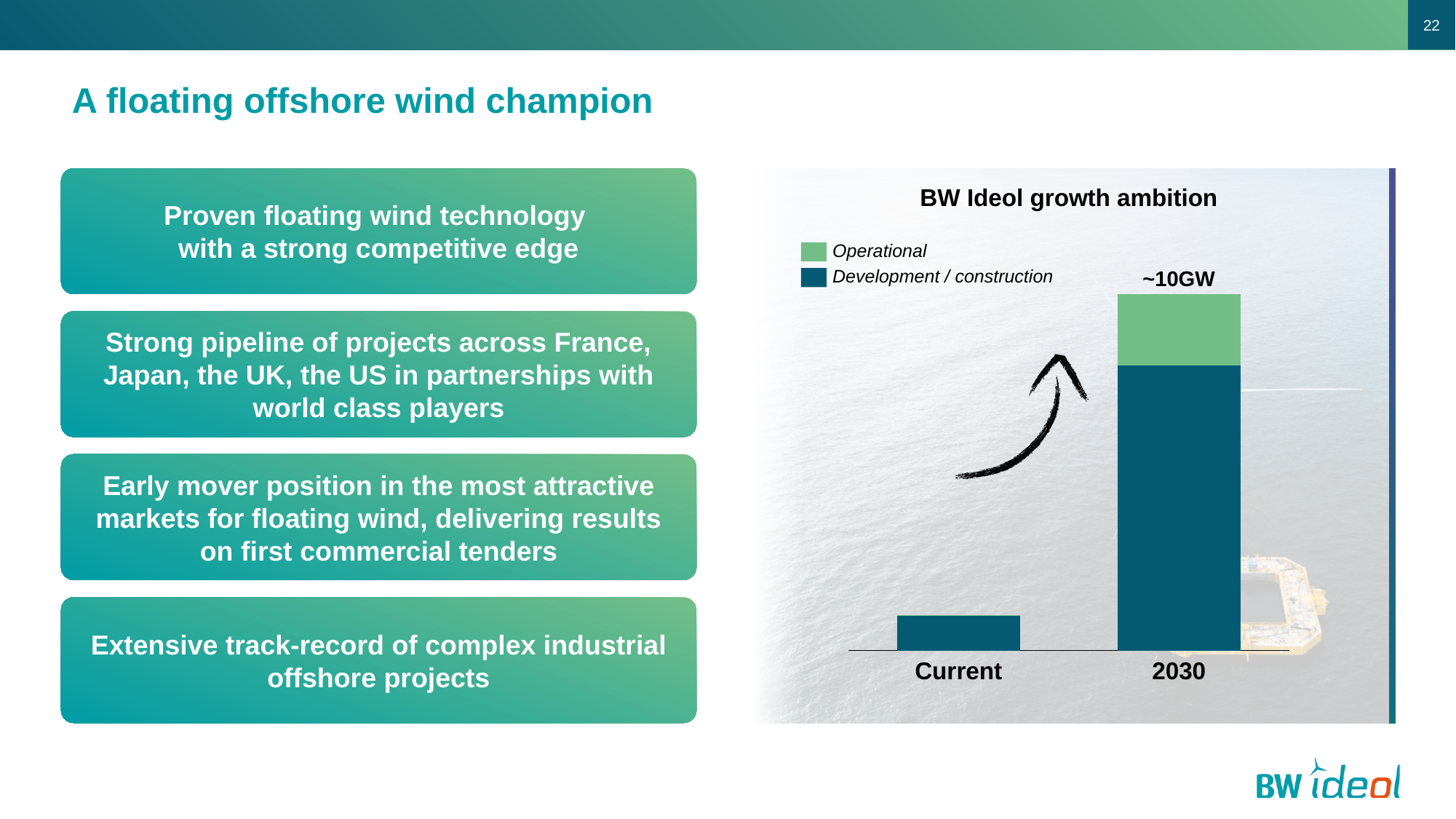
What kind of chart is shown on the slide? Stacked bar chart Do the bar values rise or fall from Current to 2030? Rise What are the two series listed in the chart's legend? Operational and Development / construction What is the title of the chart on the slide? BW Ideol growth ambition Which category has the lowest total in the chart? Current What value label is printed above the 2030 bar? ~10GW Which category has the highest total in the chart? 2030 How many series does the chart's legend list? 2 Which category has the taller bar, Current or 2030? 2030 Which series is shown in the Current bar? Development / construction How many categories are shown on the x axis of the chart? 2 Which series forms the top segment of the 2030 bar? Operational